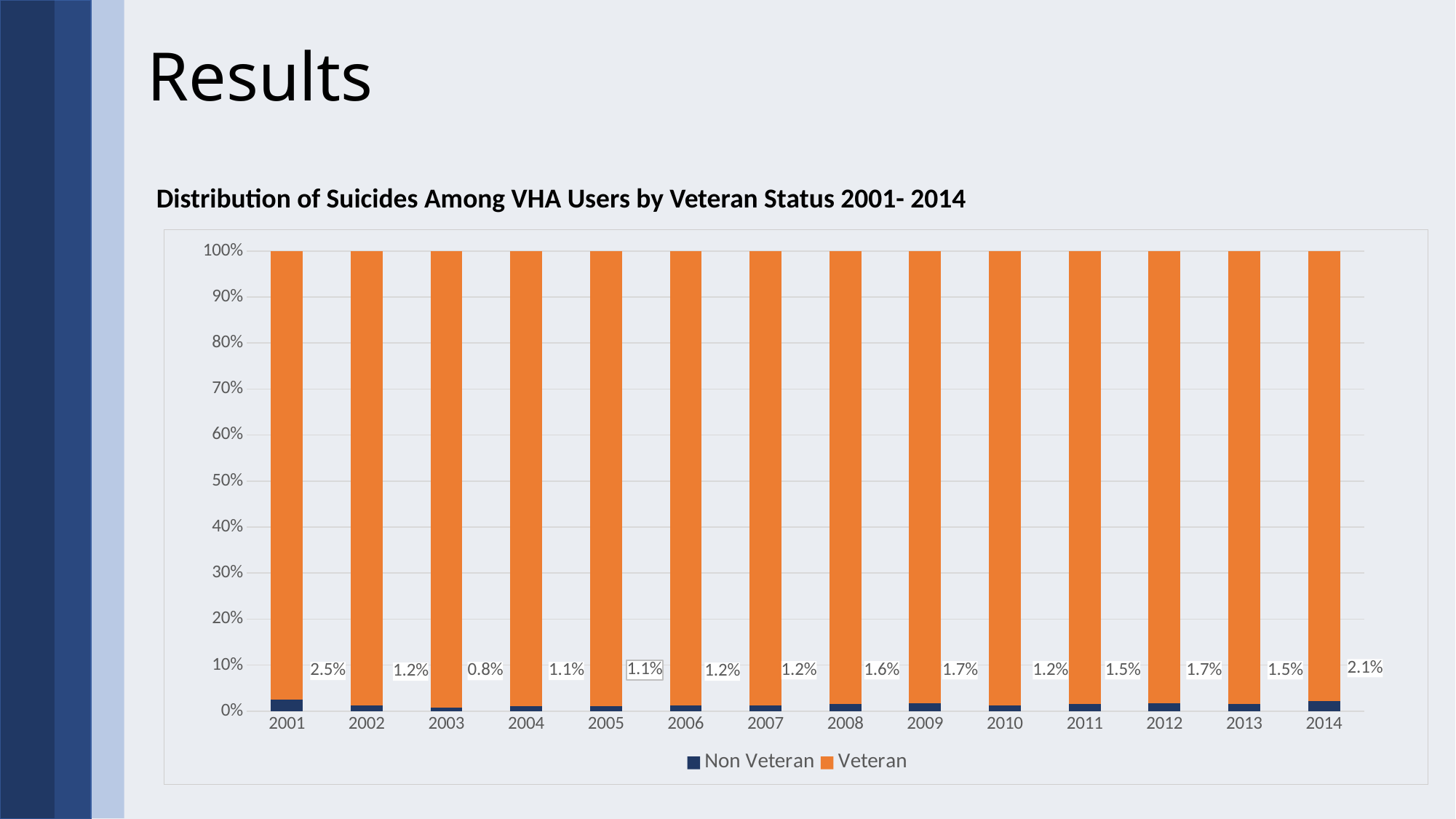
Which year has the highest Non Veteran percentage? 2001 What is the Non Veteran percentage shown for 2014? 2.1% Which year has a larger Non Veteran percentage, 2009 or 2010? 2009 Is the Veteran share of the bar for 2005 greater or less than 90%? greater How many series does the legend list? 2 What is the difference between the Non Veteran percentage in 2001 and in 2003? 1.7% What is the Non Veteran percentage shown for 2008? 1.6% Which year has the lowest Non Veteran percentage? 2003 What kind of chart is shown on the slide? Stacked bar chart How many years are shown on the x axis of the chart? 14 What is the Non Veteran share of suicides among VHA users in 2001? 2.5% What is the title of the chart? Distribution of Suicides Among VHA Users by Veteran Status 2001- 2014